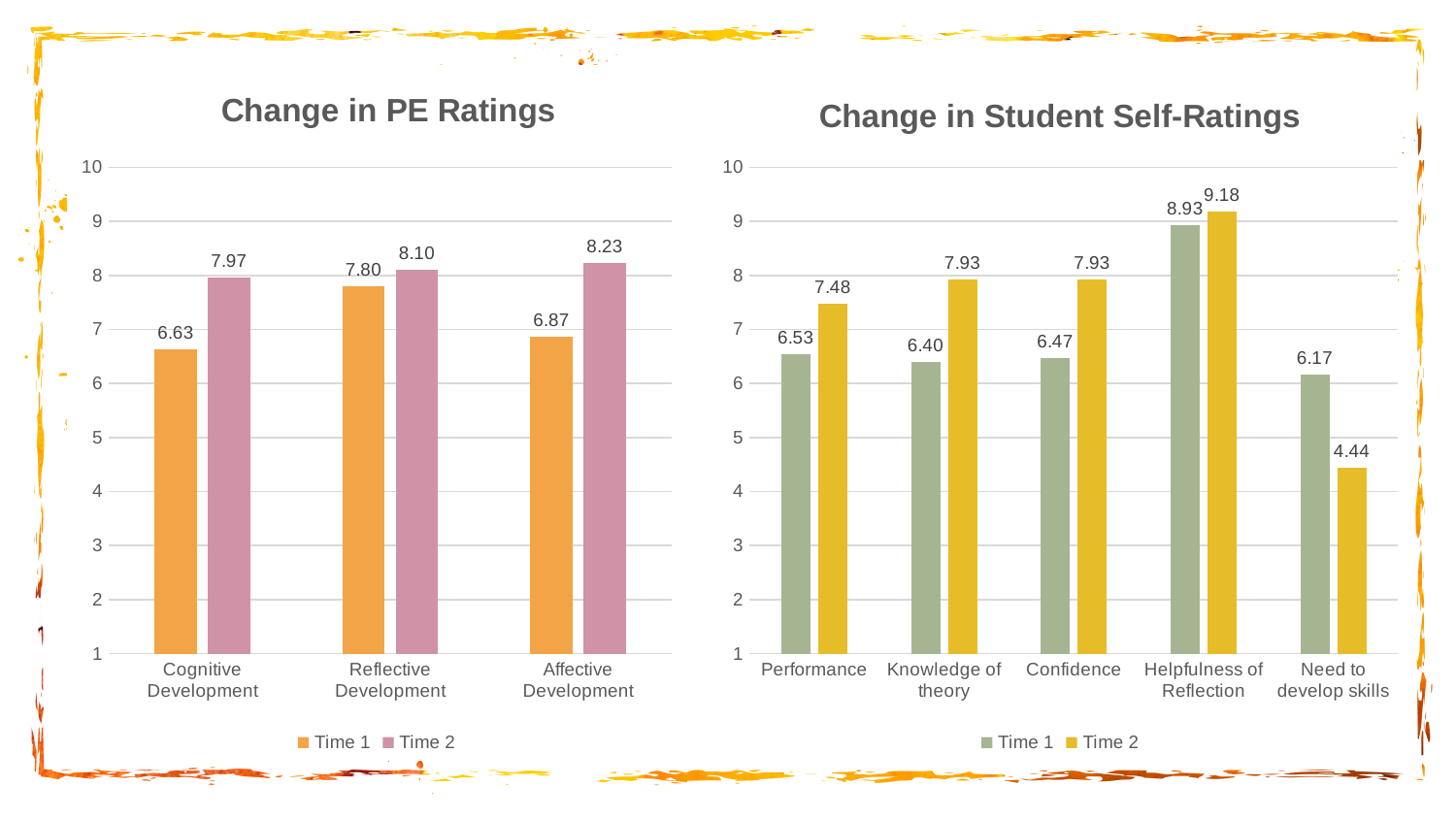
In the 'Change in Student Self-Ratings' chart, what is the Time 2 value for Need to develop skills? 4.44 In the 'Change in PE Ratings' chart, what is the Time 2 value for Affective Development? 8.23 What kind of chart is 'Change in Student Self-Ratings'? Bar chart In the 'Change in PE Ratings' chart, which category has the highest Time 1 value? Reflective Development In the 'Change in Student Self-Ratings' chart, which category has the highest Time 2 value? Helpfulness of Reflection In the 'Change in PE Ratings' chart, what is the Time 1 value for Cognitive Development? 6.63 In the 'Change in PE Ratings' chart, what is the difference between the Time 2 and Time 1 values for Cognitive Development? 1.34 In the 'Change in Student Self-Ratings' chart, is the Time 1 value for Performance larger or the Time 2 value for Performance? Time 2 In the 'Change in Student Self-Ratings' chart, what is the Time 1 value for Knowledge of theory? 6.40 In the 'Change in Student Self-Ratings' chart, which category has the lowest Time 2 value? Need to develop skills In the 'Change in PE Ratings' chart, how many categories are shown on the x axis? 3 In the 'Change in Student Self-Ratings' chart, how many series does the legend list? 2